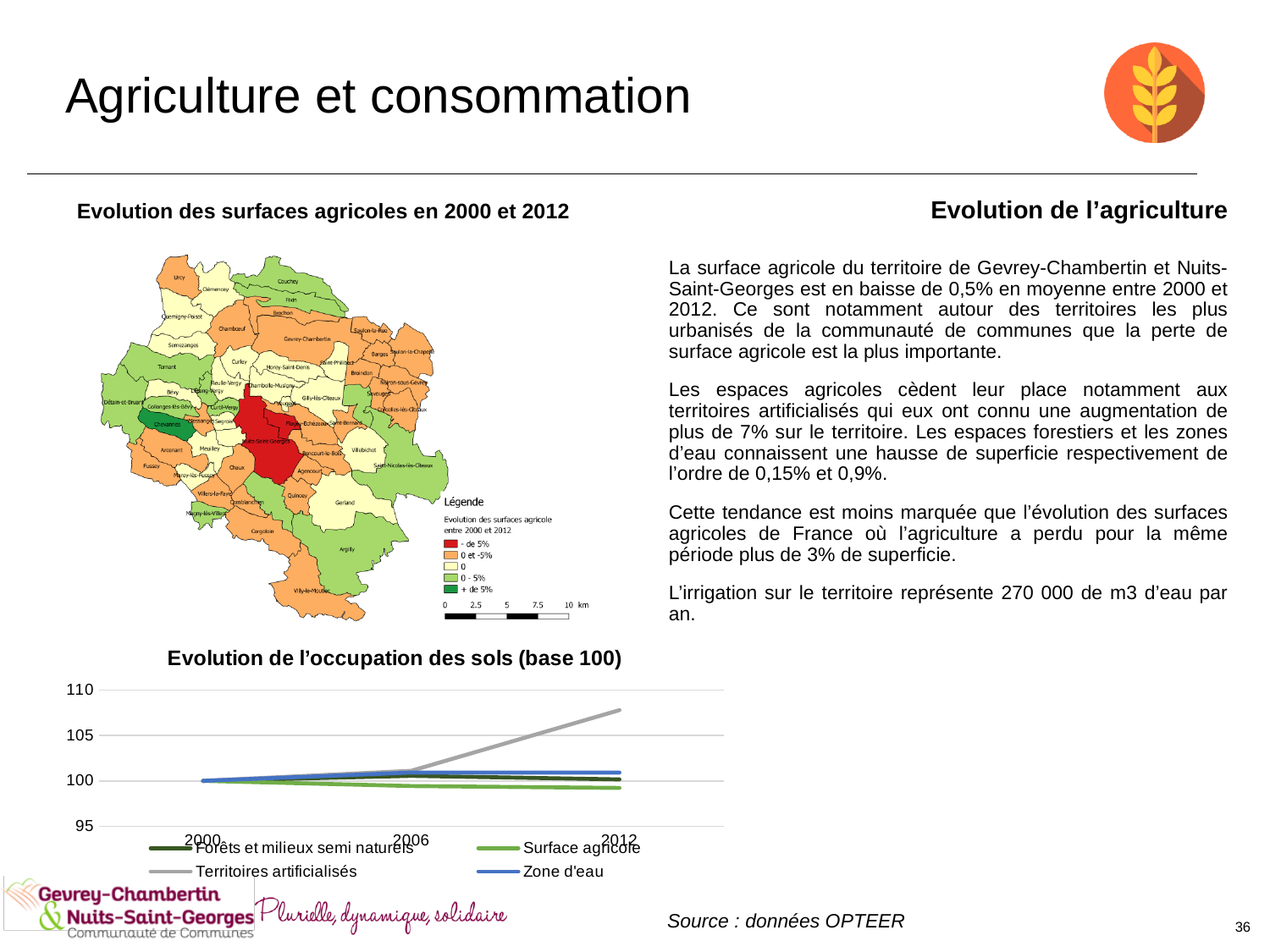
In the 'Evolution de l'occupation des sols (base 100)' chart, which series has the highest value in 2012? Territoires artificialisés In the 'Evolution de l'occupation des sols (base 100)' chart, which is larger in 2012: 'Territoires artificialisés' or 'Surface agricole'? Territoires artificialisés In the 'Evolution de l'occupation des sols (base 100)' chart, which series has the lowest value in 2012? Surface agricole In the 'Evolution de l'occupation des sols (base 100)' chart, does the 'Territoires artificialisés' series rise or fall from 2000 to 2012? rise What kind of chart is 'Evolution de l'occupation des sols (base 100)'? line chart In the 'Evolution de l'occupation des sols (base 100)' chart, what colour is the 'Territoires artificialisés' line? grey In the 'Evolution de l'occupation des sols (base 100)' chart, is the value for 'Surface agricole' in 2012 greater or less than 100? less In the 'Evolution de l'occupation des sols (base 100)' chart, is the value for 'Territoires artificialisés' in 2012 greater or less than 105? greater In the 'Evolution de l'occupation des sols (base 100)' chart, does the 'Surface agricole' series rise or fall from 2000 to 2012? fall How many years are shown on the x axis of the 'Evolution de l'occupation des sols (base 100)' chart? 3 How many series does the legend of the 'Evolution de l'occupation des sols (base 100)' chart list? 4 What is the title of the line chart at the bottom of the slide? Evolution de l'occupation des sols (base 100)